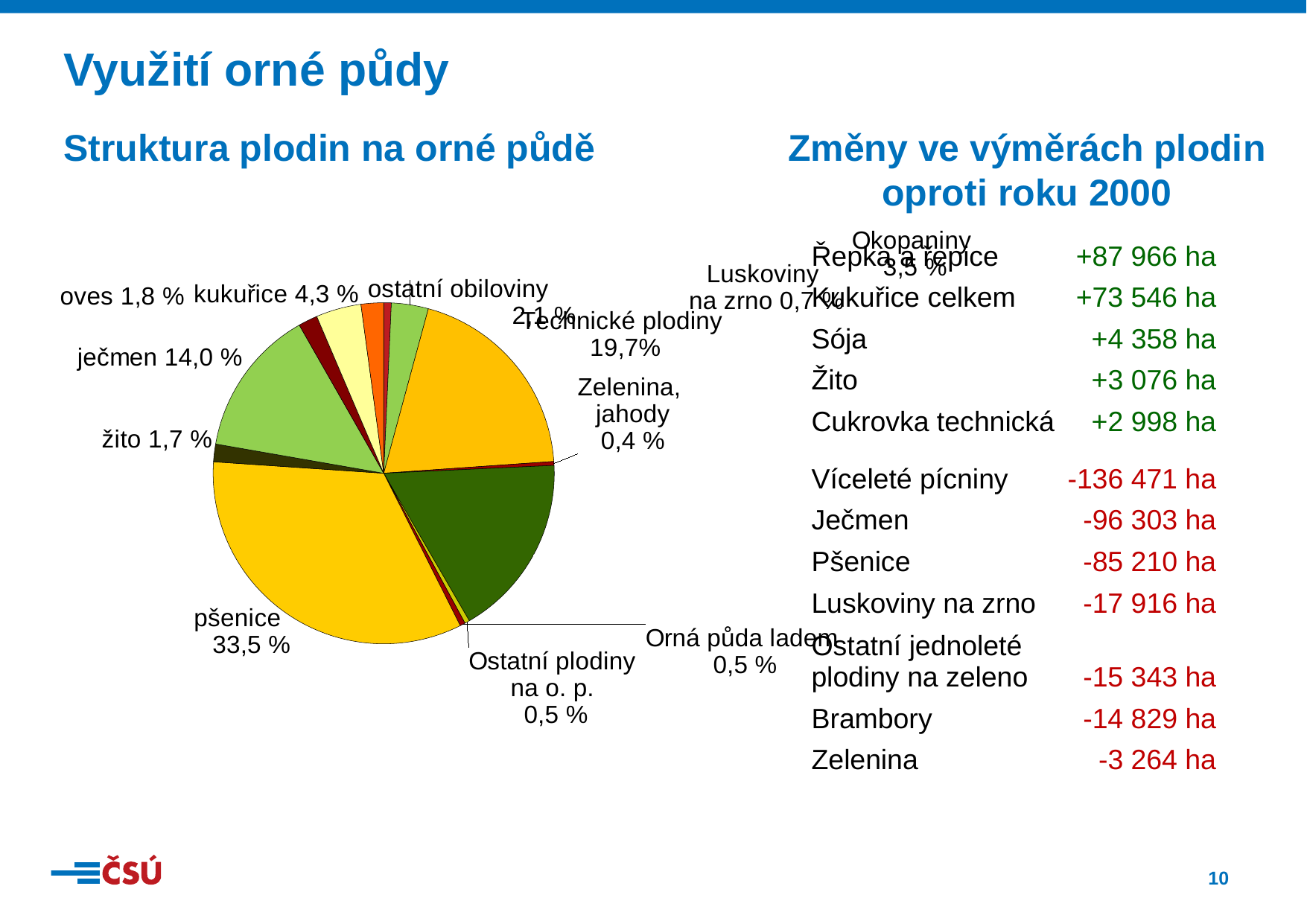
In the pie chart 'Struktura plodin na orné půdě', what share is shown for oves? 1,8 % In the pie chart 'Struktura plodin na orné půdě', which labelled crop has the largest share? pšenice In the pie chart 'Struktura plodin na orné půdě', how many percentage points larger is the share of pšenice than that of ječmen? 19,5 In the pie chart 'Struktura plodin na orné půdě', which has the larger share, ječmen or Technické plodiny? Technické plodiny In the pie chart 'Struktura plodin na orné půdě', what share is shown for žito? 1,7 % In the pie chart 'Struktura plodin na orné půdě', which has the larger share, oves or kukuřice? kukuřice In the pie chart 'Struktura plodin na orné půdě', what share is shown for ječmen? 14,0 % In the pie chart 'Struktura plodin na orné půdě', what share is shown for Technické plodiny? 19,7% In the pie chart 'Struktura plodin na orné půdě', what share is shown for Zelenina, jahody? 0,4 % What kind of chart is shown on the left side of the slide? pie chart In the pie chart 'Struktura plodin na orné půdě', what share is shown for kukuřice? 4,3 % In the pie chart 'Struktura plodin na orné půdě', what share is shown for pšenice? 33,5 %